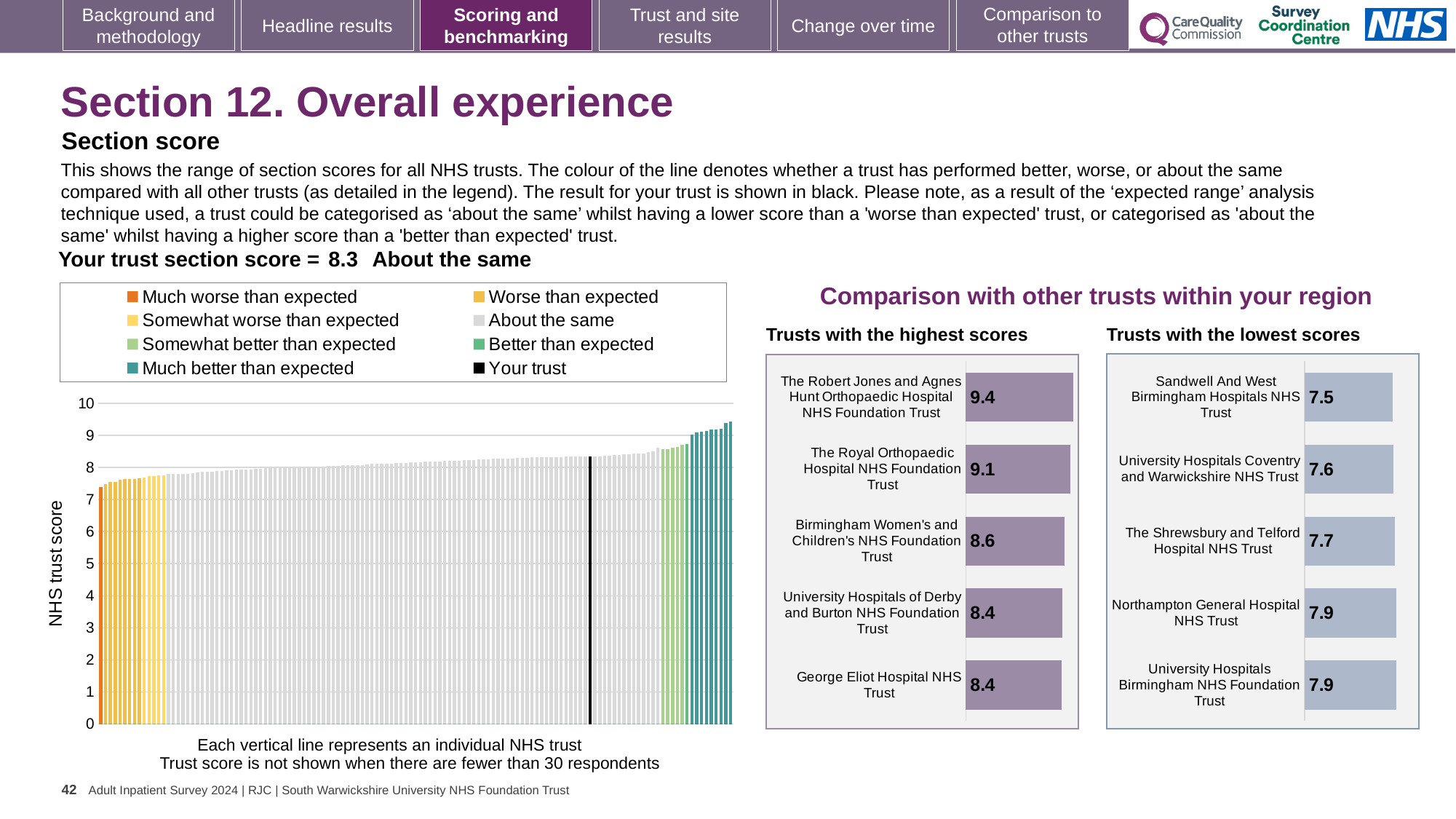
In the 'Trusts with the lowest scores' chart, what is the score for Sandwell And West Birmingham Hospitals NHS Trust? 7.5 In the 'Trusts with the lowest scores' chart, what is the score for University Hospitals Coventry and Warwickshire NHS Trust? 7.6 In the 'Trusts with the highest scores' chart, which has the larger score: Birmingham Women's and Children's NHS Foundation Trust or University Hospitals of Derby and Burton NHS Foundation Trust? Birmingham Women's and Children's NHS Foundation Trust What kind of chart is the NHS trust score chart on the left of the slide? Bar chart What is the section score for your trust shown on the slide? 8.3 In the 'Trusts with the highest scores' chart, which trust has the highest score? The Robert Jones and Agnes Hunt Orthopaedic Hospital NHS Foundation Trust In the 'Trusts with the highest scores' chart, what is the score for The Robert Jones and Agnes Hunt Orthopaedic Hospital NHS Foundation Trust? 9.4 In the 'Trusts with the lowest scores' chart, which trust has the lowest score? Sandwell And West Birmingham Hospitals NHS Trust How many trusts are listed in the 'Trusts with the lowest scores' chart? 5 In the 'Trusts with the highest scores' chart, what is the difference between the scores of The Robert Jones and Agnes Hunt Orthopaedic Hospital NHS Foundation Trust and The Royal Orthopaedic Hospital NHS Foundation Trust? 0.3 In the NHS trust score chart on the left, do the values rise or fall from left to right? Rise How many entries does the legend of the NHS trust score chart on the left list? 8